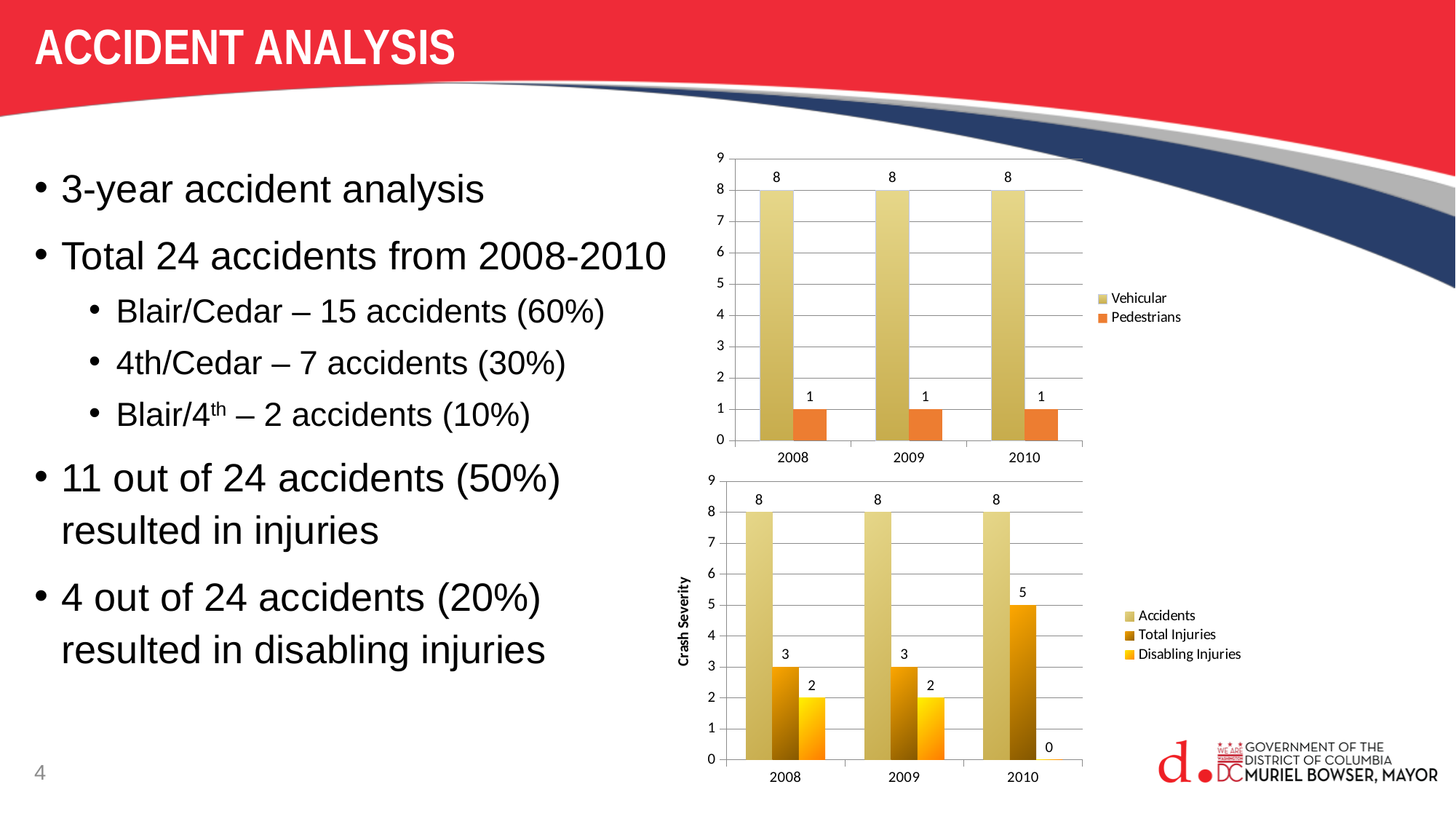
In the top chart, how many series does the legend list? 2 In the top chart, what is the value for Vehicular in 2009? 8 In the top chart, what is the difference between Vehicular and Pedestrians in 2008? 7 What type of chart is the bottom chart? Bar chart In the bottom chart, what is the value for Total Injuries in 2010? 5 In the bottom chart, which year has the highest Total Injuries value? 2010 In the bottom chart, what is the value for Disabling Injuries in 2010? 0 In the top chart, how many years are shown on the x axis? 3 In the bottom chart, which year has the lowest Disabling Injuries value? 2010 In the bottom chart, how many series does the legend list? 3 In the bottom chart, what is the difference between Accidents and Total Injuries in 2009? 5 In the top chart, what is the value for Pedestrians in 2010? 1